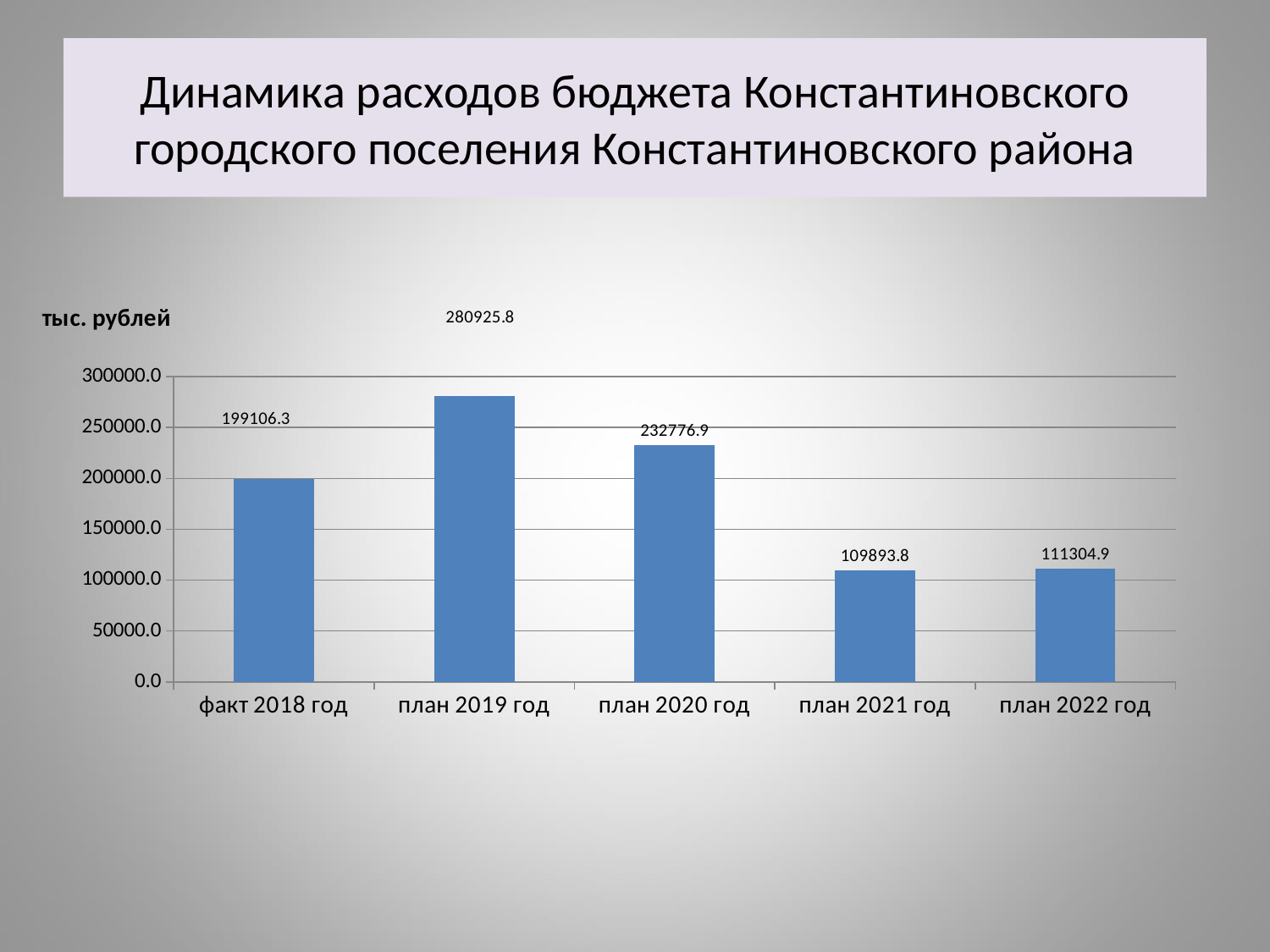
Which category has the lowest value? план 2021 год What is the difference between the values for план 2019 год and факт 2018 год? 81819.5 What kind of chart is shown on the slide? bar chart What unit is indicated above the vertical axis of the chart? тыс. рублей What is the difference between the values for план 2022 год and план 2021 год? 1411.1 Which category has the highest value? план 2019 год What is the value for план 2019 год? 280925.8 Which is larger, the value for план 2019 год or план 2020 год? план 2019 год Is the value for план 2021 год greater or less than 150000.0? less What is the value for план 2022 год? 111304.9 What is the value for факт 2018 год? 199106.3 How many categories are shown on the x axis? 5